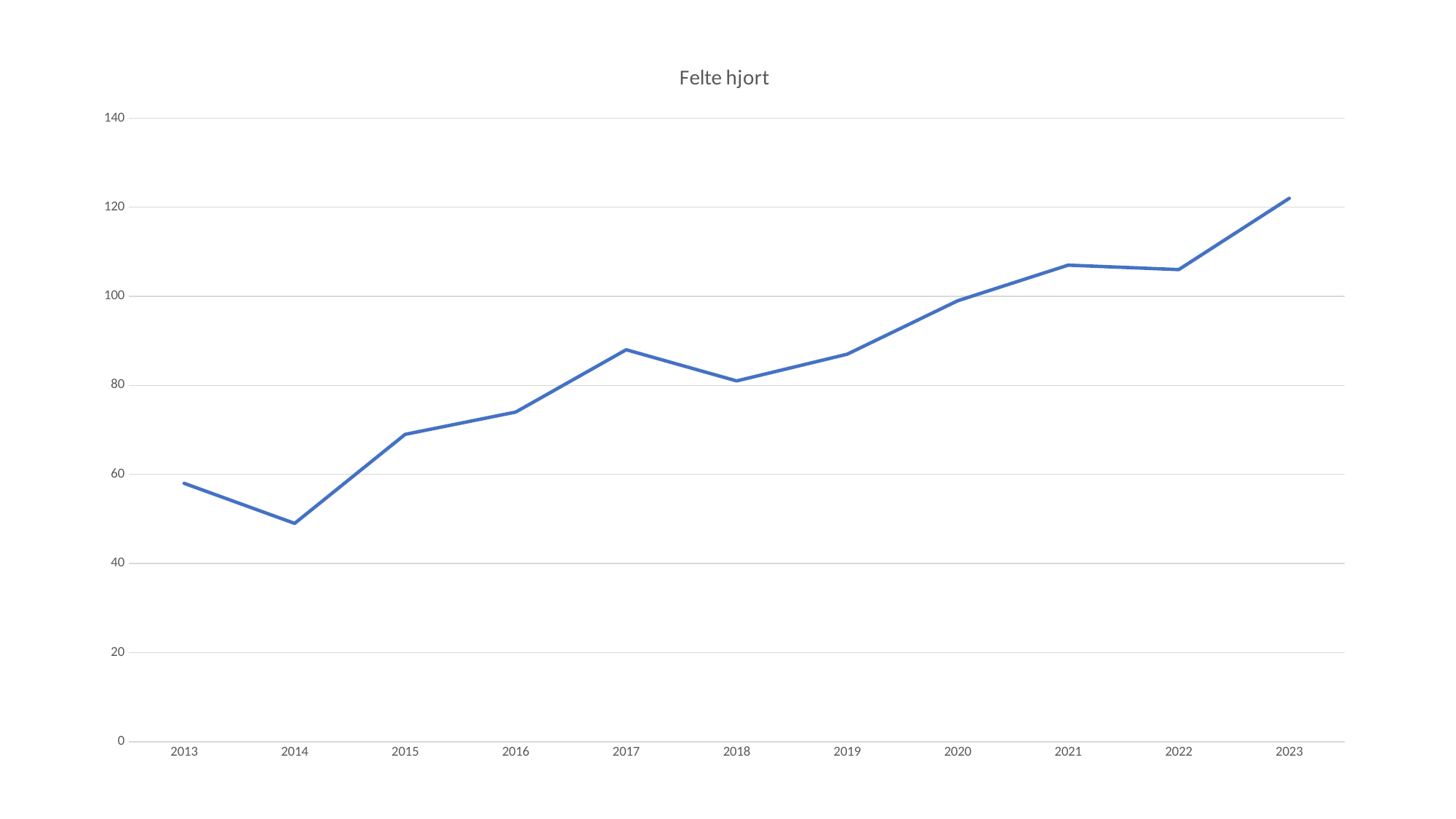
What is the title of the chart? Felte hjort Is the value for 2016 greater or less than 80? less Is the value for 2017 greater or less than 80? greater Do the values generally rise or fall from 2013 to 2023? rise Which year has the highest value? 2023 How many years are plotted on the x axis? 11 Is the value for 2021 greater or less than 100? greater Which is larger, the value for 2013 or the value for 2015? 2015 What kind of chart is shown on the slide? line chart Which year has the lowest value? 2014 Which is larger, the value for 2017 or the value for 2018? 2017